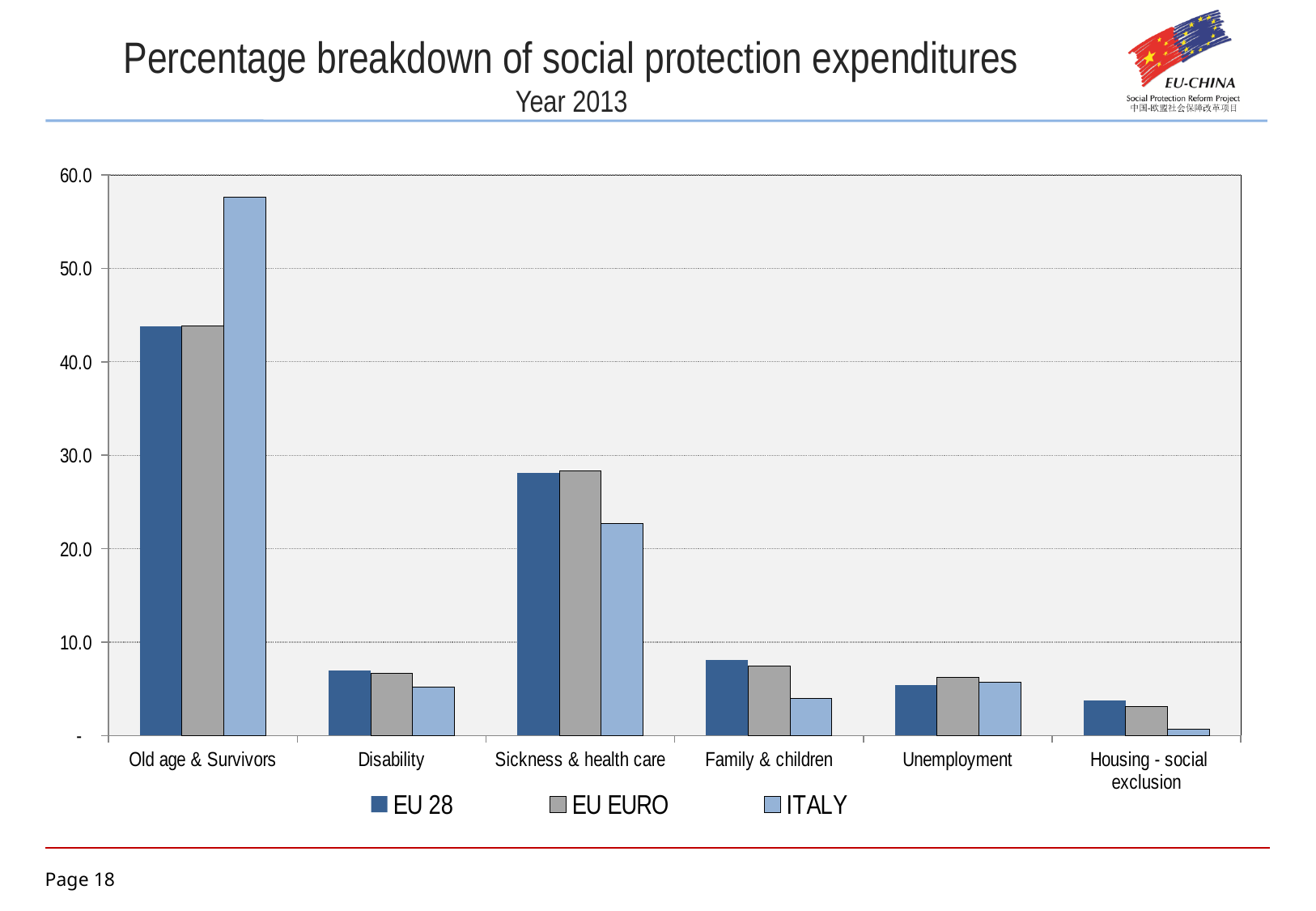
Which category has the lowest value for ITALY? Housing - social exclusion Which category has the highest value for ITALY? Old age & Survivors For Sickness & health care, which is larger: the EU 28 value or the ITALY value? EU 28 Is the EU 28 value for Sickness & health care greater or less than 30.0? less For Old age & Survivors, which is larger: the ITALY value or the EU 28 value? ITALY How many expenditure categories are shown on the x axis? 6 How many series does the legend list? 3 Is the ITALY value for Old age & Survivors greater or less than 50.0? greater What are the three series named in the legend? EU 28, EU EURO, ITALY Is the ITALY value for Family & children greater or less than 10.0? less What kind of chart is shown on the slide? bar chart